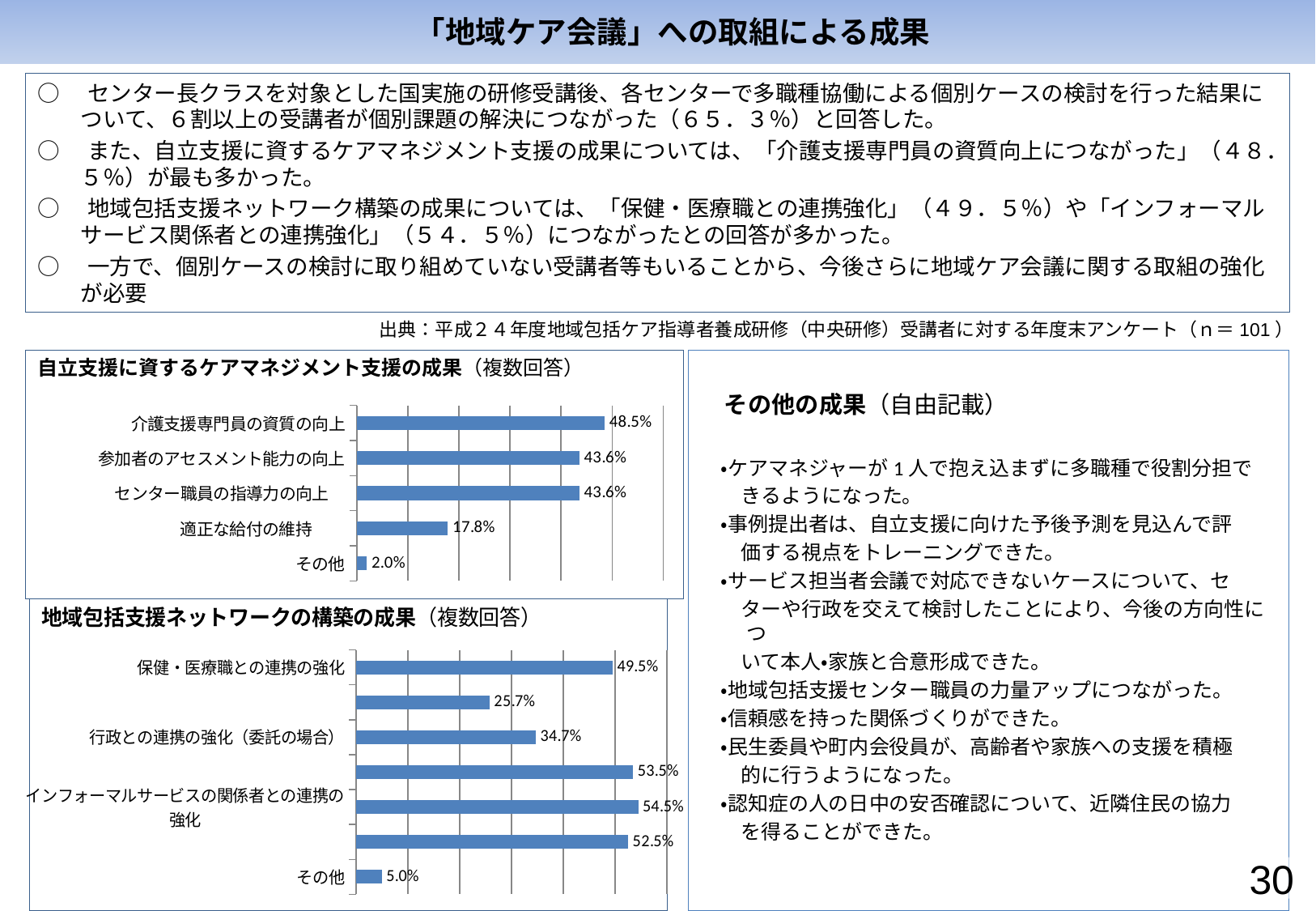
In the chart titled 地域包括支援ネットワークの構築の成果, what is the value for 保健・医療職との連携の強化? 49.5% In the chart titled 地域包括支援ネットワークの構築の成果, what is the value for 行政との連携の強化（委託の場合）? 34.7% In the chart titled 自立支援に資するケアマネジメント支援の成果, what is the value for 介護支援専門員の資質の向上? 48.5% In the chart titled 地域包括支援ネットワークの構築の成果, which is larger: 保健・医療職との連携の強化 or 行政との連携の強化（委託の場合）? 保健・医療職との連携の強化 In the chart titled 自立支援に資するケアマネジメント支援の成果, which category has the highest value? 介護支援専門員の資質の向上 In the chart titled 地域包括支援ネットワークの構築の成果, what is the value for インフォーマルサービスの関係者との連携の強化? 54.5% In the chart titled 自立支援に資するケアマネジメント支援の成果, which category has the lowest value? その他 What type of chart is the chart titled 地域包括支援ネットワークの構築の成果? Bar chart In the chart titled 自立支援に資するケアマネジメント支援の成果, what is the value for 適正な給付の維持? 17.8% In the chart titled 自立支援に資するケアマネジメント支援の成果, how many categories are shown? 5 In the chart titled 自立支援に資するケアマネジメント支援の成果, what is the difference between 介護支援専門員の資質の向上 and 適正な給付の維持? 30.7% In the chart titled 地域包括支援ネットワークの構築の成果, how many bars are shown? 7